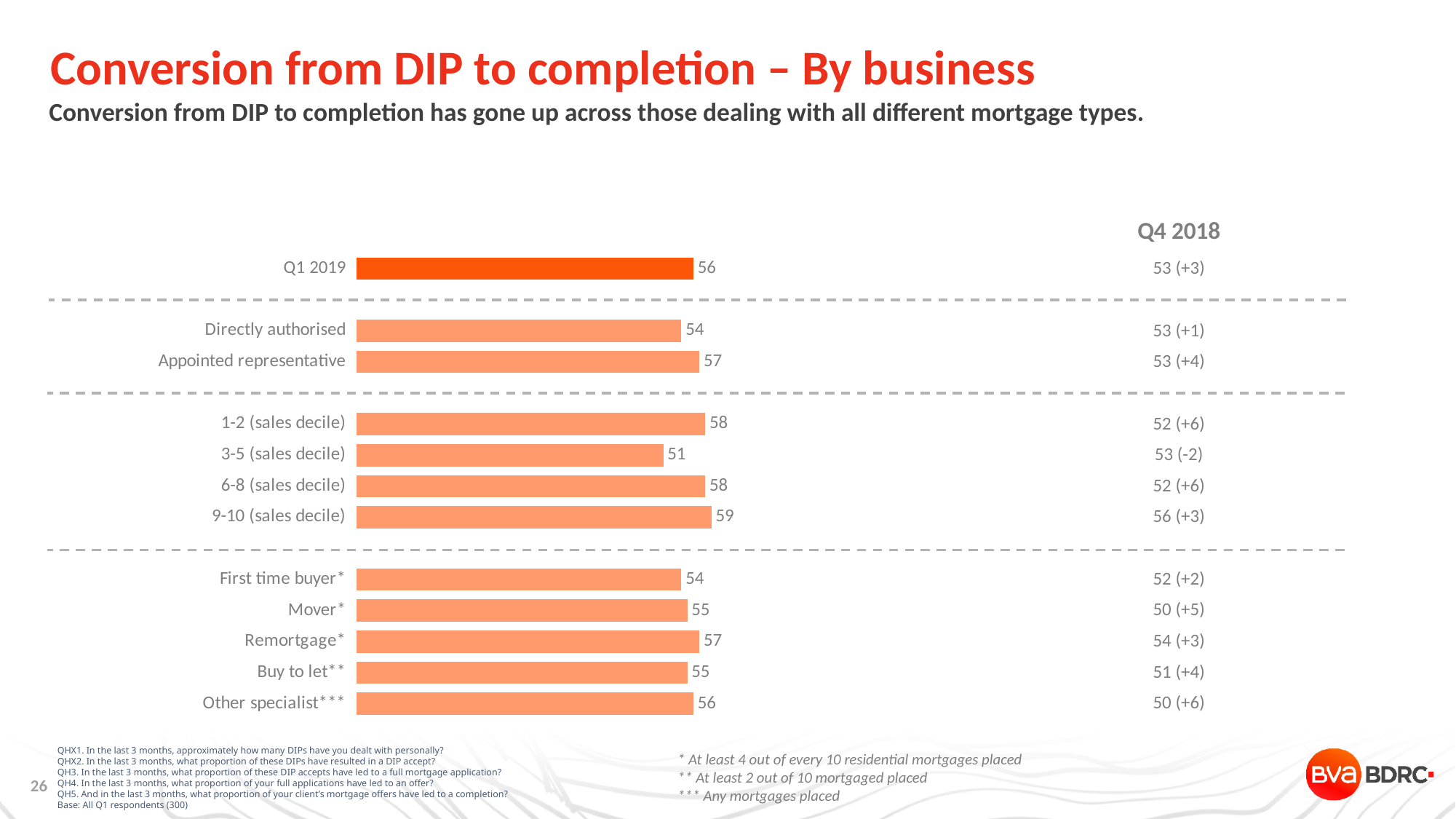
Which is larger, the value for Directly authorised or the value for Appointed representative? Appointed representative What is the Q4 2018 value shown for Other specialist? 50 (+6) What is the difference between the Q1 2019 value and the Q4 2018 value for the overall Q1 2019 row? 3 Which bar is shown in a darker orange colour than the others? Q1 2019 What is the difference between the values for 9-10 (sales decile) and 3-5 (sales decile)? 8 What is the value for Appointed representative? 57 What is the value for 3-5 (sales decile)? 51 How many bars are plotted in the chart? 12 What kind of chart is shown on the slide? Bar chart Which category has the highest value? 9-10 (sales decile) Which category has the lowest value? 3-5 (sales decile) What is the value for Remortgage? 57